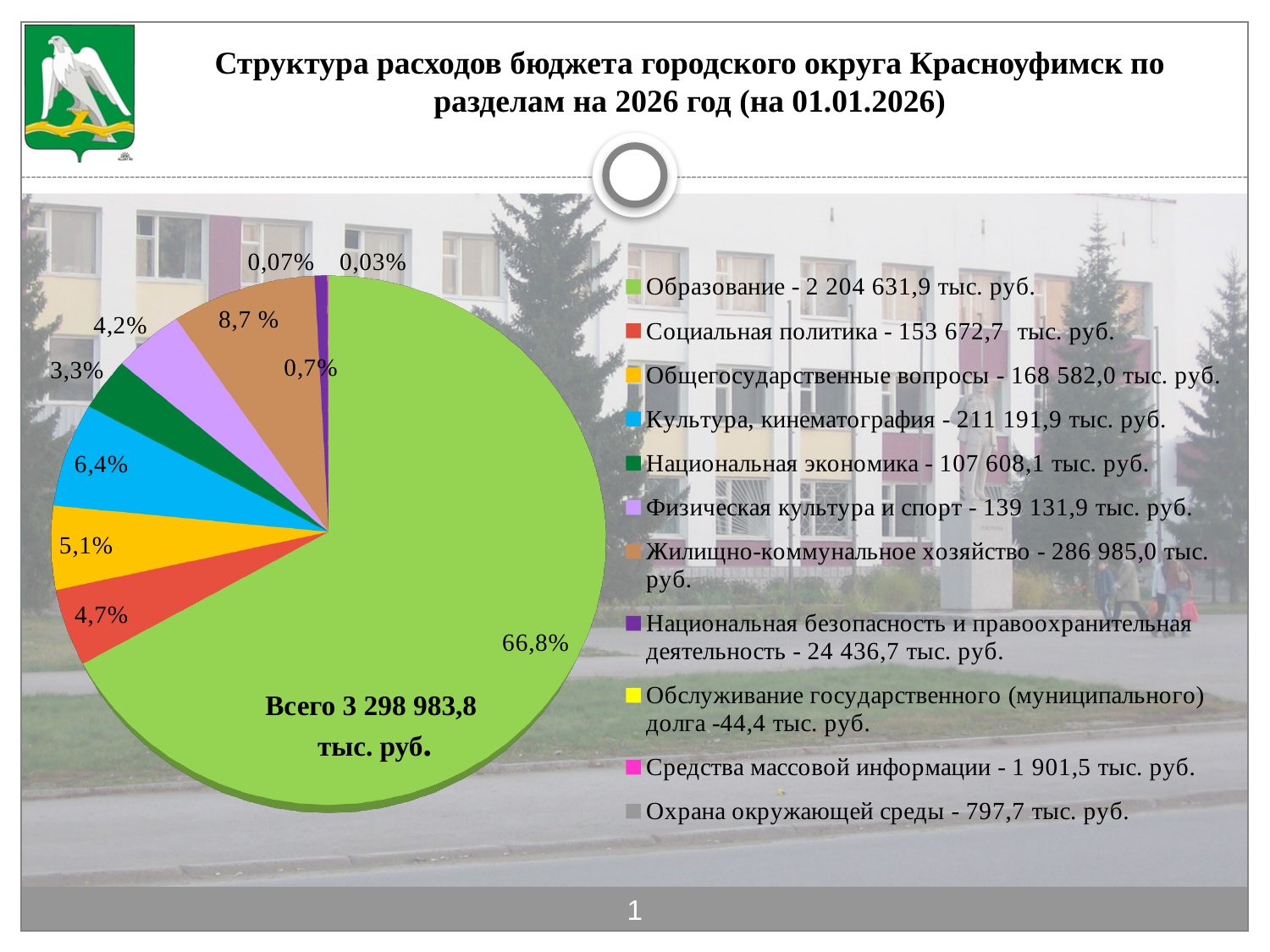
What share of the pie does Социальная политика take? 4,7% What share of the pie does Жилищно-коммунальное хозяйство take? 8,7 % Which category has the largest share of the pie? Образование What share of the pie does Образование take? 66,8% Which is larger: Жилищно-коммунальное хозяйство or Культура, кинематография? Жилищно-коммунальное хозяйство Which category has the smallest value in the legend? Обслуживание государственного (муниципального) долга What is the value for Образование according to the legend? 2 204 631,9 тыс. руб. What kind of chart is shown on the slide? pie chart What is the value for Национальная экономика according to the legend? 107 608,1 тыс. руб. What is the difference between the values for Культура, кинематография and Общегосударственные вопросы? 42 609,9 тыс. руб. How many categories does the legend of the pie chart list? 11 What total amount is printed on the pie chart? 3 298 983,8 тыс. руб.